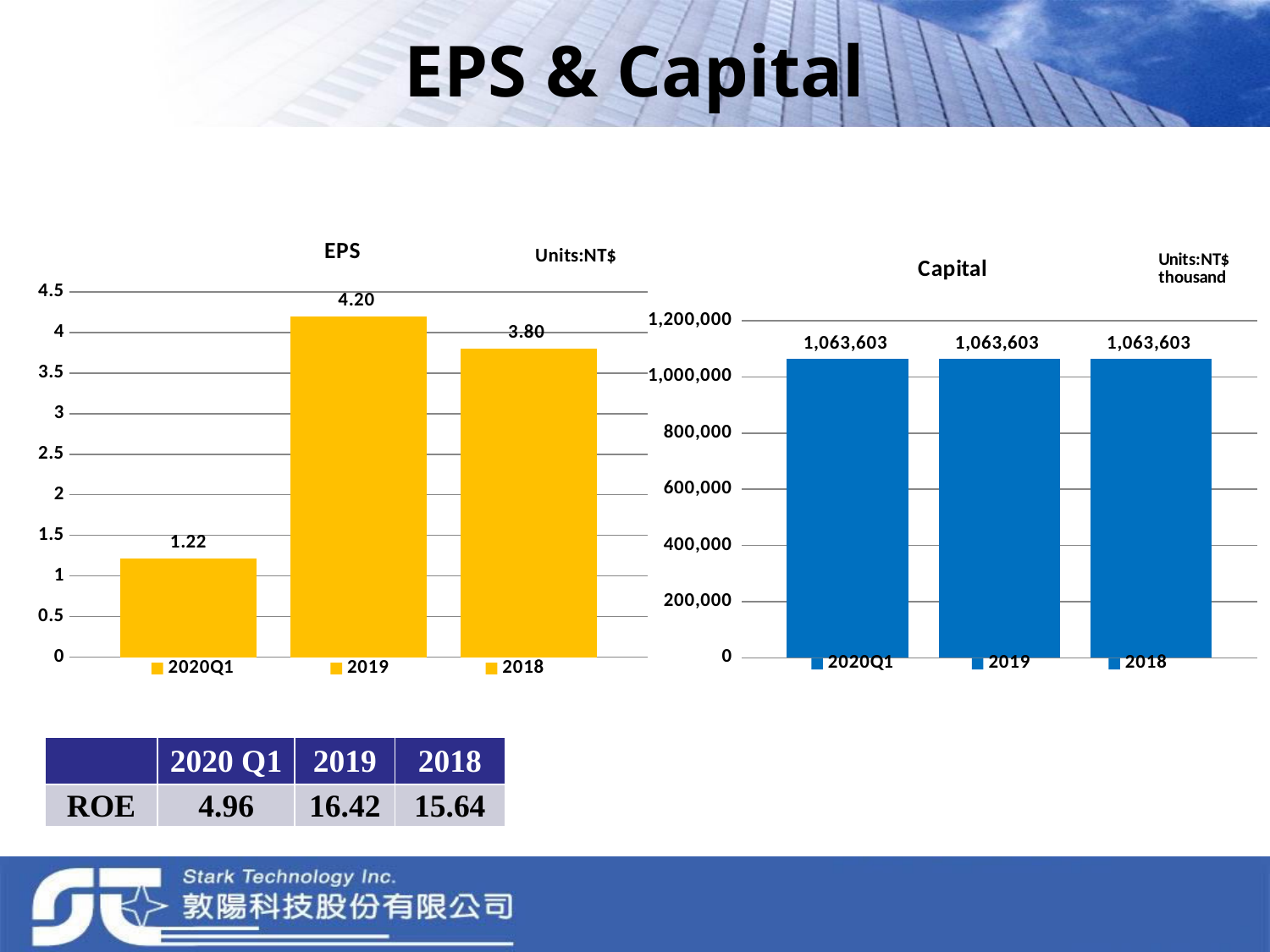
In the EPS chart, what is the value for 2018? 3.80 In the EPS chart, which is larger, the value for 2018 or the value for 2020Q1? 2018 What units are stated for the Capital chart? NT$ thousand In the EPS chart, what is the value for 2019? 4.20 In the Capital chart, what is the value for 2019? 1,063,603 In the EPS chart, which category has the lowest value? 2020Q1 In the Capital chart, is the value for 2018 greater or less than 1,000,000? greater In the EPS chart, what is the value for 2020Q1? 1.22 In the EPS chart, what is the difference between the 2019 and 2018 values? 0.40 How many bars are shown in the Capital chart? 3 In the EPS chart, which category has the highest value? 2019 What kind of chart is the Capital chart? bar chart